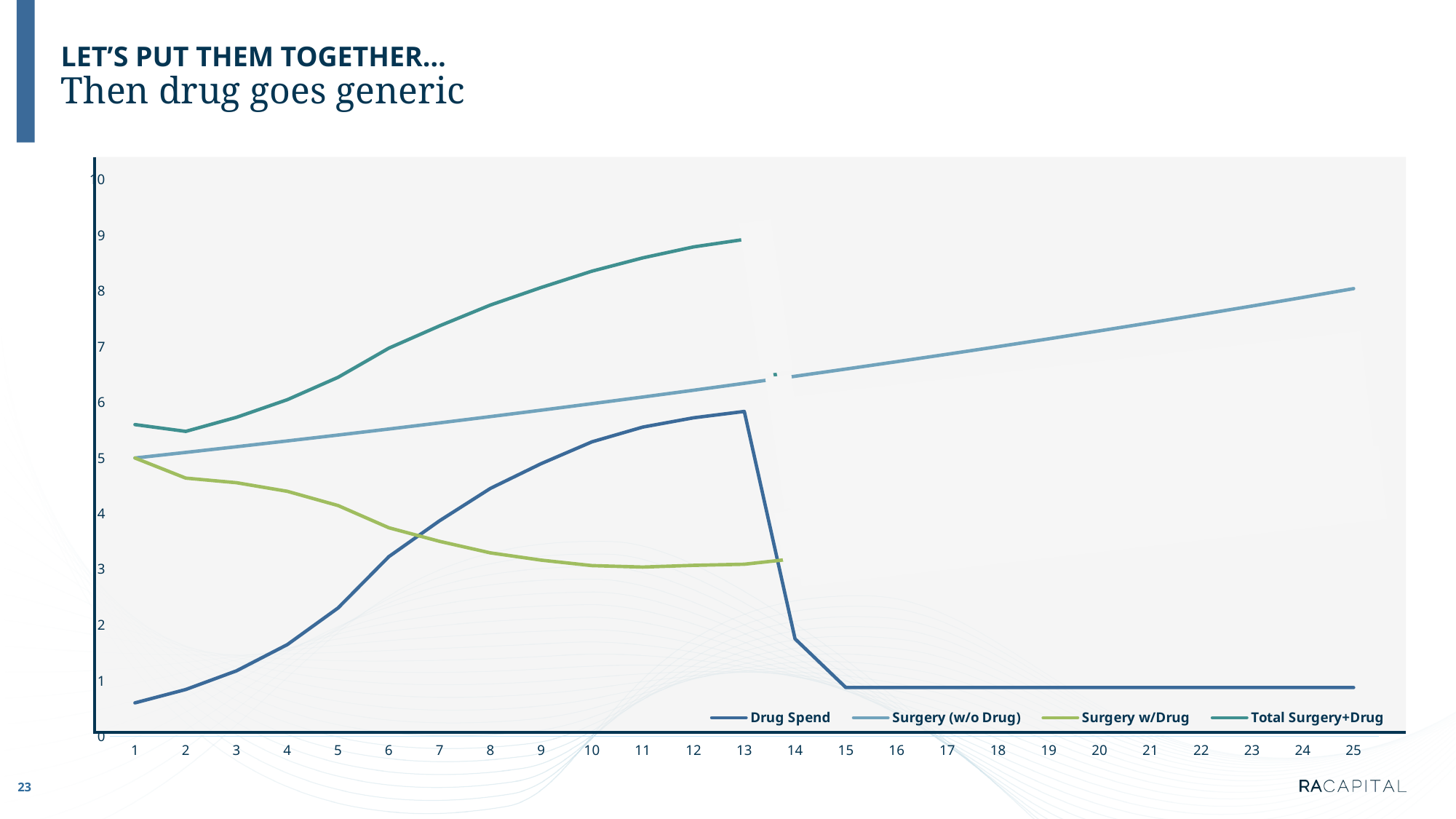
Is the value of Drug Spend at x = 13 greater or less than 5? greater Is the value of Surgery (w/o Drug) at x = 25 greater or less than 7? greater What kind of chart is shown on the slide? line chart Is the value of Drug Spend at x = 20 greater or less than 2? less Does the Surgery (w/o Drug) line rise or fall from x = 1 to x = 25? rise How many series does the legend list? 4 Which series has the highest value at x = 13? Total Surgery+Drug At x = 5, which is larger: Drug Spend or Surgery w/Drug? Surgery w/Drug How many points are labelled along the x axis? 25 Does the Surgery w/Drug line rise or fall from x = 1 to x = 13? fall